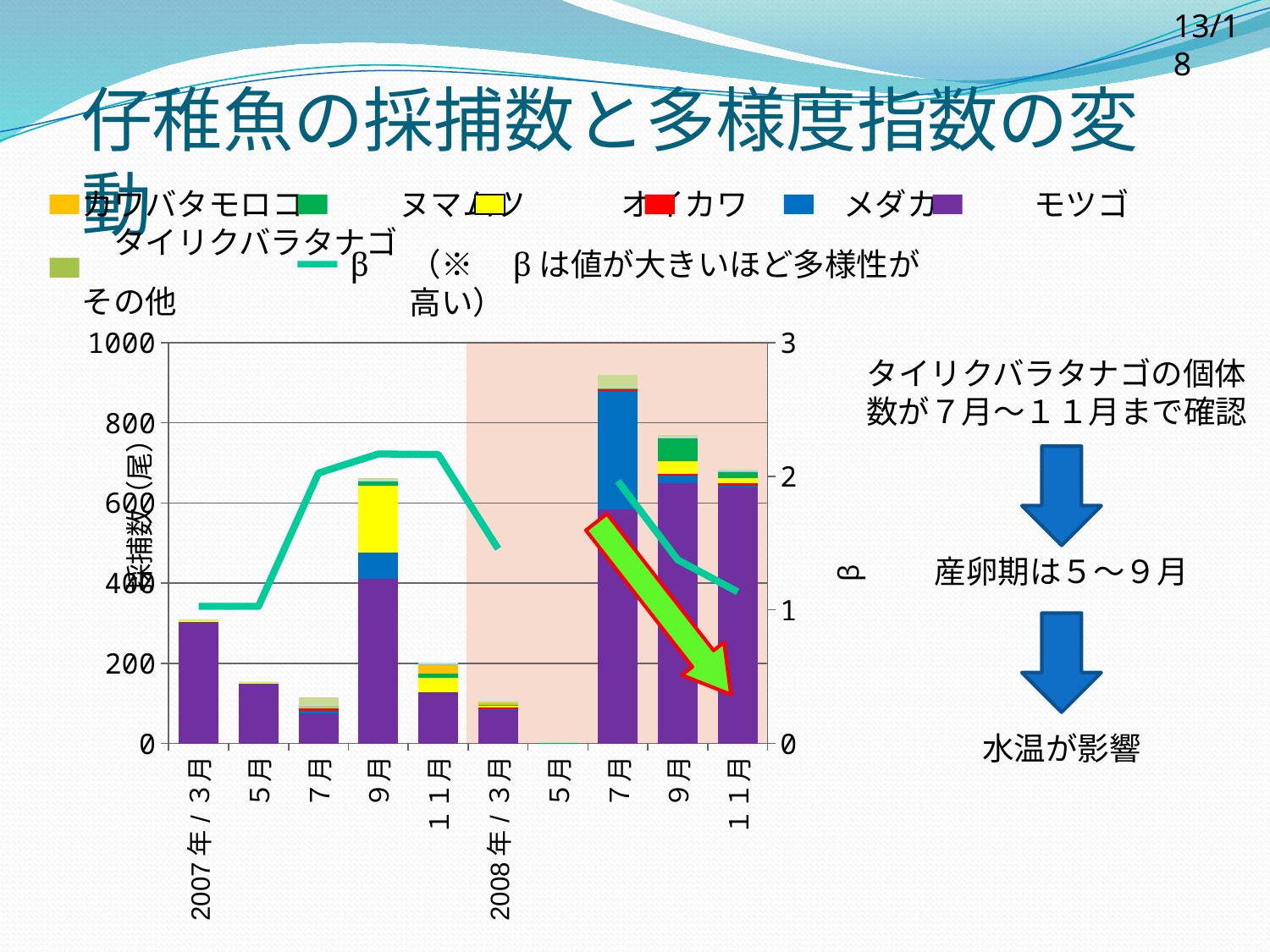
Which has the larger total catch, 2008年/7月 or 2007年/9月? 2008年/7月 Is the total catch for 2008年/7月 greater or less than 800? greater Is the total catch for 2007年/5月 greater or less than 200? less How many categories (months) are shown on the x axis of the chart? 10 Which series (colour purple) makes up the largest part of most stacked bars? タイリクバラタナゴ Which month has the highest total catch (tallest stacked bar)? 2008年/7月 Is the total catch for 2007年/3月 greater or less than 200? greater Which month has the lowest total catch (shortest stacked bar)? 2008年/5月 What kind of chart is shown on the slide? stacked bar chart with a line Does the β line rise or fall from 2008年/7月 to 2008年/11月? fall How many series does the chart's legend list? 8